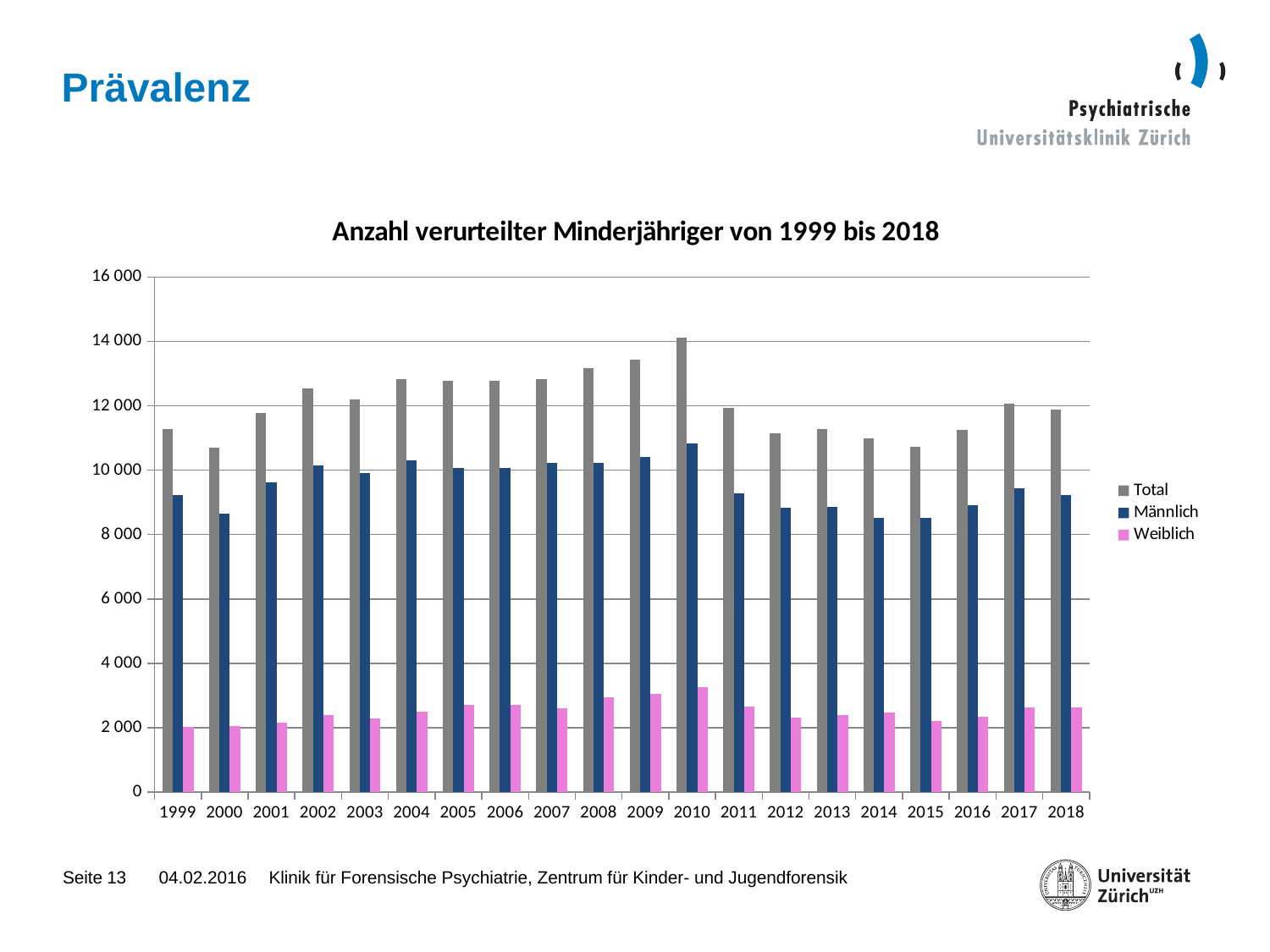
How many series does the legend list? 3 Is the Männlich value for 2014 greater or less than 10 000? less In which year is the Männlich value highest? 2010 Does the Total value rise or fall from 2010 to 2015? fall Is the Total value for 2010 greater or less than 12 000? greater How many years are shown on the x axis? 20 What is the title of the chart? Anzahl verurteilter Minderjähriger von 1999 bis 2018 In which year is the Total value highest? 2010 Which is larger, the Männlich value for 2002 or for 2012? 2002 What kind of chart is shown on the slide? bar chart In which year is the Weiblich value highest? 2010 Is the Weiblich value for 2010 greater or less than 3 000? greater